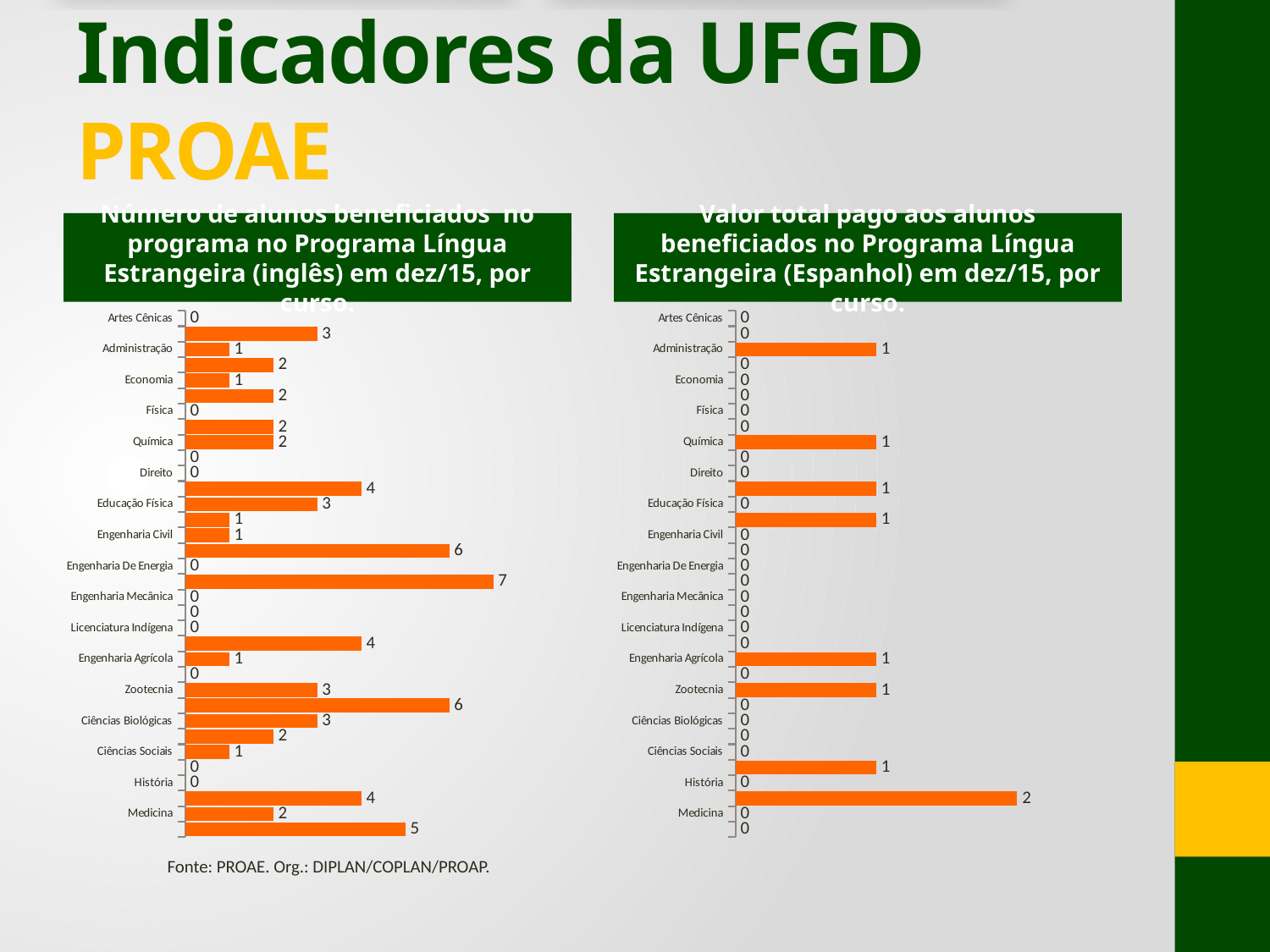
In the left chart (inglês), what is the value for Medicina? 2 What type of chart is used in the left chart, 'Número de alunos beneficiados no programa no Programa Língua Estrangeira (inglês) em dez/15, por curso'? Bar chart How many charts are shown on the slide? 2 In the right chart (Espanhol), what is the value for Administração? 1 In the left chart (inglês), what is the value for Química? 2 In the right chart (Espanhol), what is the highest value shown on any bar? 2 In the left chart (inglês), which is larger, the value for Ciências Biológicas or the value for Ciências Sociais? Ciências Biológicas In the left chart (inglês), what is the highest value shown on any bar? 7 In the right chart (Espanhol), what is the value for Engenharia Agrícola? 1 In the left chart (inglês), what is the difference between the value for Educação Física and the value for Administração? 2 In the left chart (inglês), what is the value for Zootecnia? 3 In the left chart (inglês), what is the value for Educação Física? 3